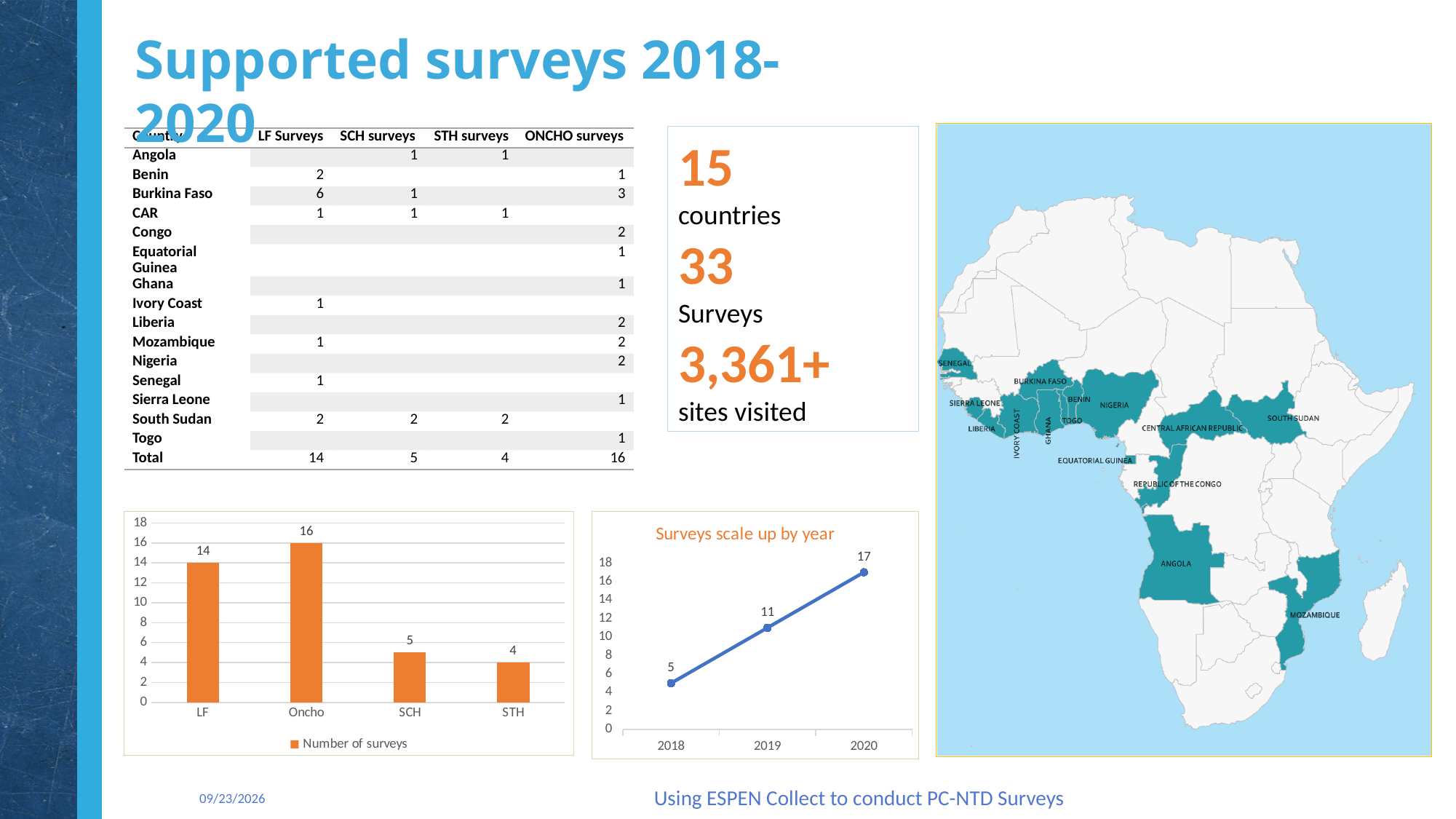
In the bar chart at the bottom left, which has more surveys, LF or SCH? LF In the 'Surveys scale up by year' chart, what is the difference between the values for 2020 and 2018? 12 In the 'Surveys scale up by year' chart, what is the value for 2019? 11 How many categories are shown in the bar chart at the bottom left? 4 In the bar chart at the bottom left, what is the number of surveys for STH? 4 In the bar chart at the bottom left, what is the difference between the number of surveys for Oncho and LF? 2 What is the legend entry shown in the bar chart at the bottom left? Number of surveys In the bar chart at the bottom left, which category has the lowest number of surveys? STH In the bar chart at the bottom left, which category has the highest number of surveys? Oncho In the 'Surveys scale up by year' chart, do the values rise or fall from 2018 to 2020? Rise What kind of chart is the chart at the bottom left? Bar chart In the bar chart at the bottom left, what is the number of surveys for Oncho? 16